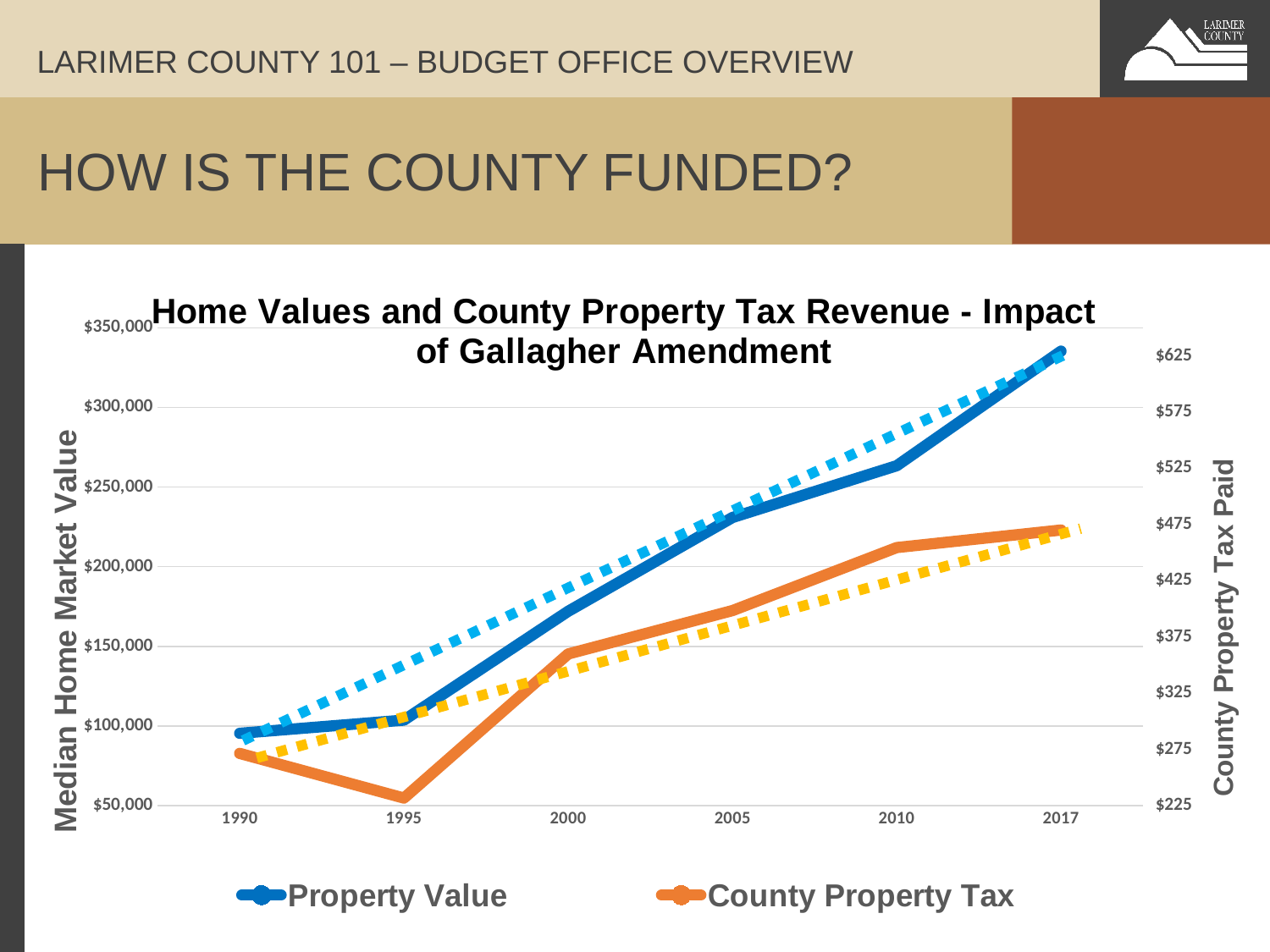
Is the Property Value in 2005 greater or less than $200,000? greater In which year is the County Property Tax line at its lowest? 1995 What is the title of the chart? Home Values and County Property Tax Revenue - Impact of Gallagher Amendment In which year is the Property Value line at its highest? 2017 How many years are plotted along the x axis? 6 Is the Property Value in 1990 greater or less than $100,000? less Is the Property Value in 2017 greater or less than $300,000? greater Does the Property Value line rise or fall from 1990 to 2017? rise What is the label of the left vertical axis? Median Home Market Value How many series does the legend list? 2 What kind of chart is shown on the slide? line chart